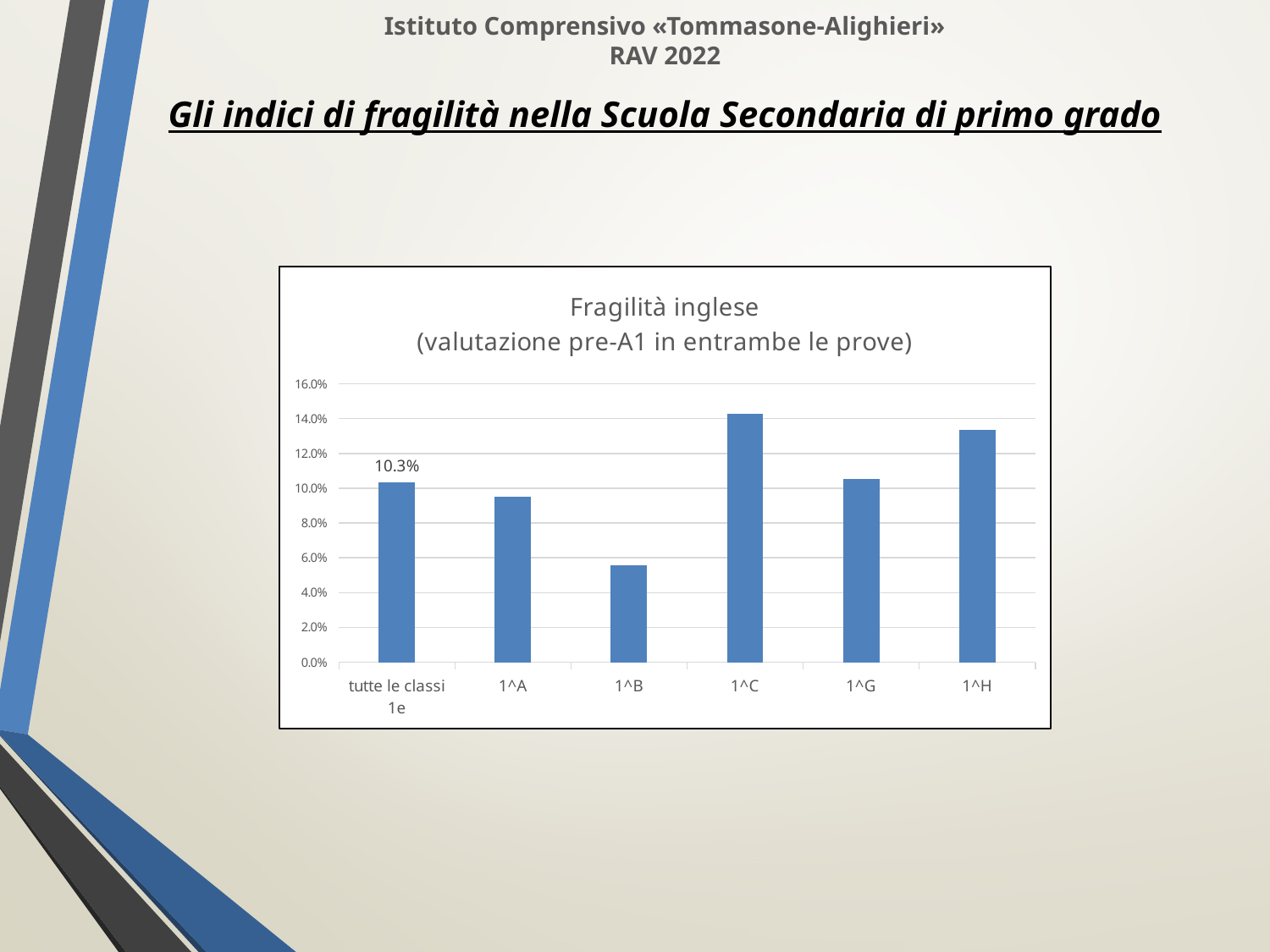
Which category has the lowest value in the chart? 1^B Which category has the highest value in the chart? 1^C How many categories are shown on the x axis of the chart? 6 Is the value for 1^B greater or less than 6.0%? less What is the title of the chart? Fragilità inglese (valutazione pre-A1 in entrambe le prove) What kind of chart is shown on the slide? Bar chart Which is larger, the value for 1^H or the value for 1^A? 1^H Is the value for 1^H greater or less than 12.0%? greater Which is larger, the value for 1^C or the value for 1^B? 1^C Is the value for 1^A greater or less than 10.0%? less What is the value for "tutte le classi 1e" in the chart? 10.3%